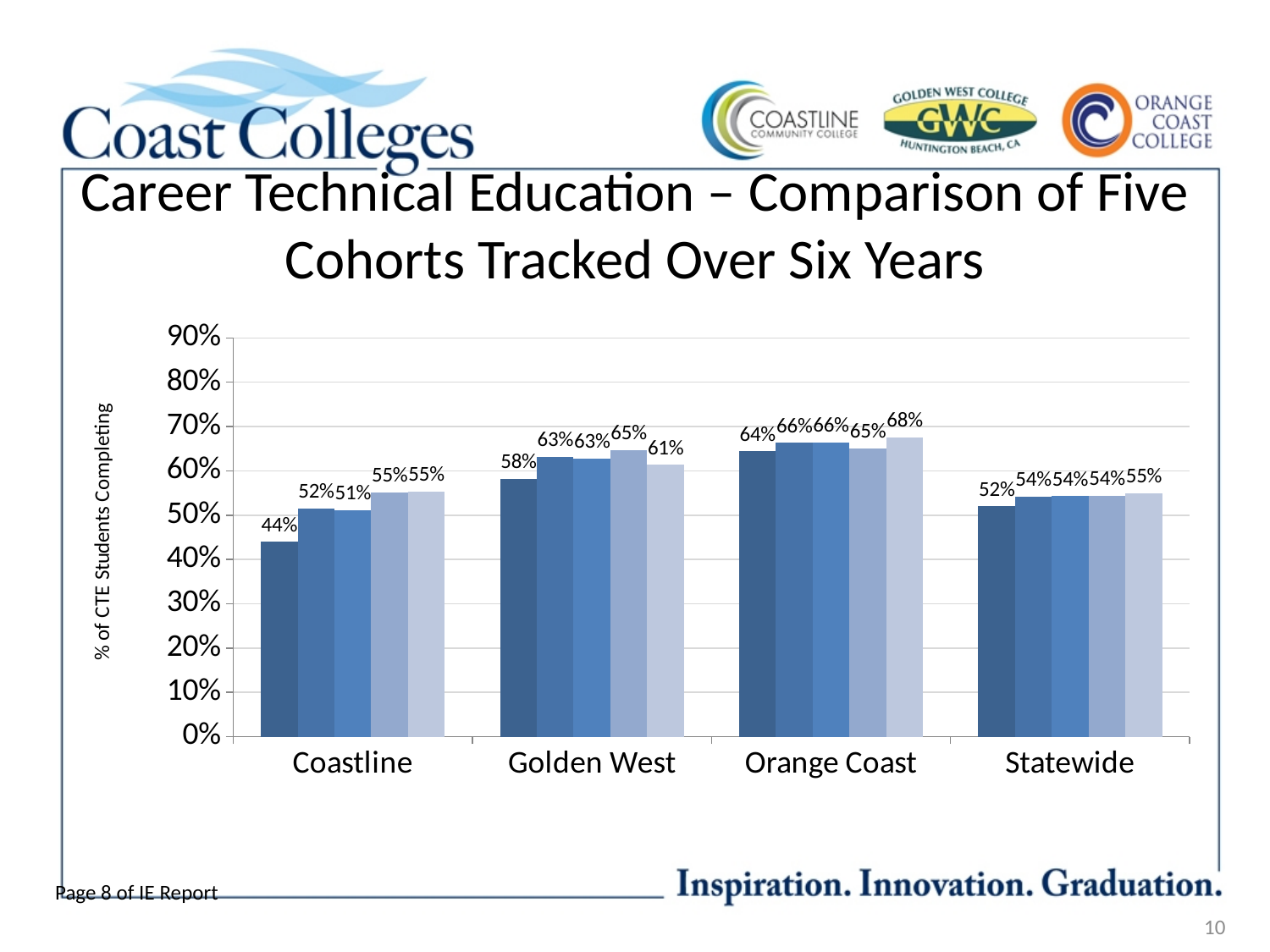
Is the first bar for Golden West larger or smaller than the first bar for Orange Coast? smaller What is the difference between the fifth bar and the first bar for Coastline? 11% What is the value of the first bar for Golden West? 58% Which category has the lowest value for its first bar? Coastline What is the value of the rightmost (fifth) bar for Orange Coast? 68% What is the value of the fifth bar for Statewide? 55% Which category has the highest value for its fifth bar? Orange Coast What is the value of the leftmost (first) bar for Coastline? 44% What is the label on the y axis of the chart? % of CTE Students Completing How many categories are shown on the x axis of the chart? 4 How many bars are plotted for each category in the chart? 5 What kind of chart is shown on the slide? bar chart